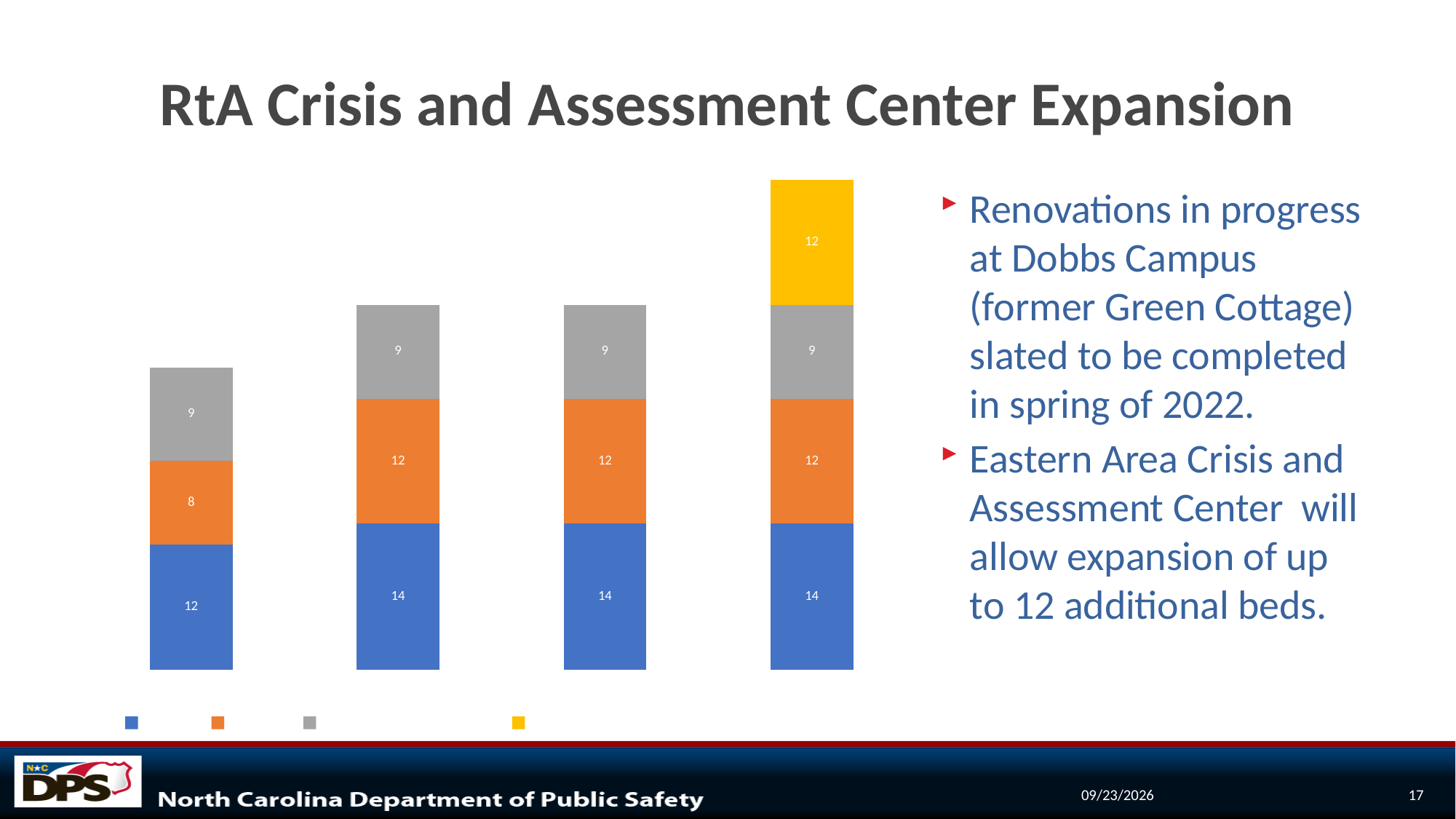
Which bar has the highest total? the fourth (rightmost) bar Which bar has the lowest total? the first (leftmost) bar What is the total of the first (leftmost) stacked bar? 29 What is the difference between the orange segment in the second bar and the orange segment in the first bar? 4 Which colour segment appears only in the fourth (rightmost) bar? yellow What is the total of the fourth (rightmost) stacked bar? 47 What is the value of the yellow segment in the fourth (rightmost) bar? 12 What is the value of the blue segment in the first (leftmost) bar? 12 What is the value of the orange segment in the first (leftmost) bar? 8 What kind of chart is shown on the slide? stacked bar chart How many series does the legend list? 4 How many bars does the chart contain? 4